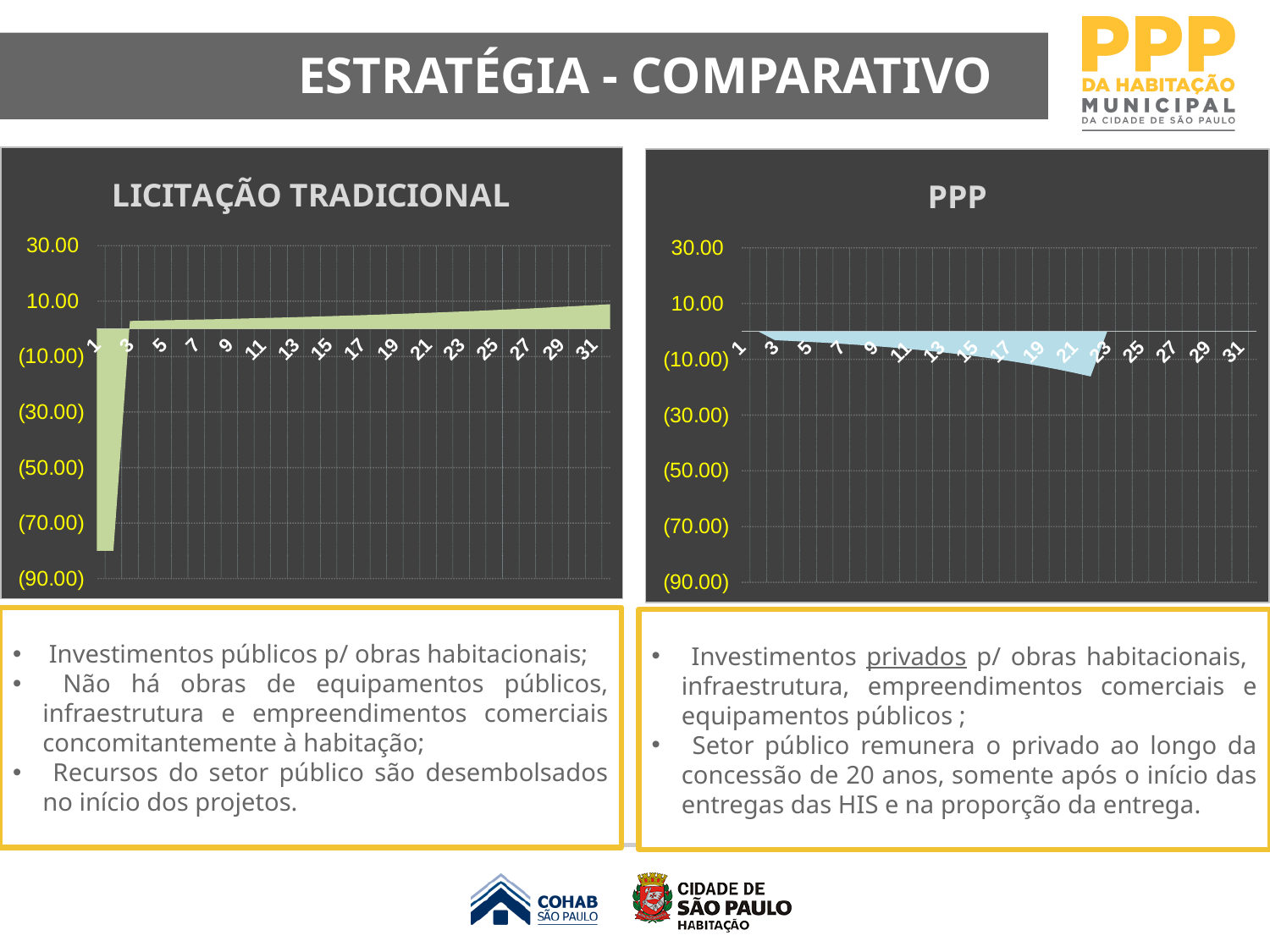
In the LICITAÇÃO TRADICIONAL chart, do the values rise or fall from point 3 to point 31? rise In the LICITAÇÃO TRADICIONAL chart, is the value at point 15 greater or less than 10.00? less In the LICITAÇÃO TRADICIONAL chart, is the value at point 1 greater or less than (70.00)? less What is the title of the chart on the right side of the slide? PPP Which chart reaches the lower minimum value, LICITAÇÃO TRADICIONAL or PPP? LICITAÇÃO TRADICIONAL In the PPP chart, do the values rise or fall from point 1 to point 21? fall In the PPP chart, is the value at point 21 greater or less than (10.00)? less What is the lowest value shown on the y axis of the PPP chart? (90.00) In the LICITAÇÃO TRADICIONAL chart, which is larger, the value at point 1 or the value at point 31? Point 31 What kind of chart is the LICITAÇÃO TRADICIONAL chart? Area chart